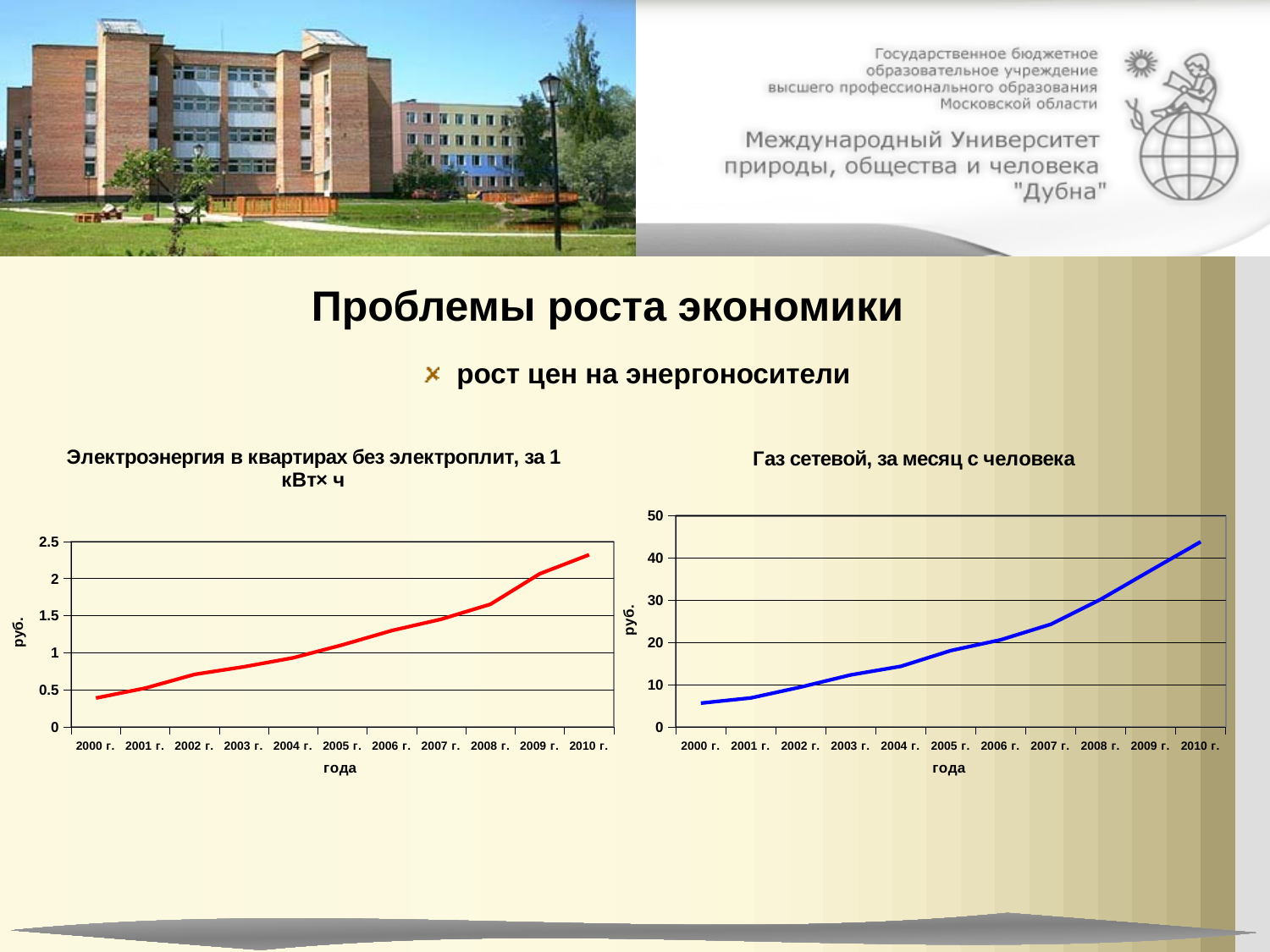
In the right chart (gas), do the values rise or fall from 2000 г. to 2010 г.? rise In the right chart (gas), which year has the lowest value? 2000 г. What is the y-axis label of the left chart (electricity)? руб. What kind of chart is the chart titled "Электроэнергия в квартирах без электроплит, за 1 кВт× ч"? line chart In the right chart (gas), is the value for 2005 г. greater or less than 20? less In the right chart (gas), is the value for 2010 г. greater or less than 40? greater In the left chart (electricity), which year has the highest value? 2010 г. In the left chart (electricity), how many years are shown on the x axis? 11 In the left chart (electricity), is the value for 2010 г. greater or less than 2? greater What kind of chart is the chart titled "Газ сетевой, за месяц с человека"? line chart In the right chart (gas), which is larger, the value for 2009 г. or the value for 2003 г.? 2009 г.